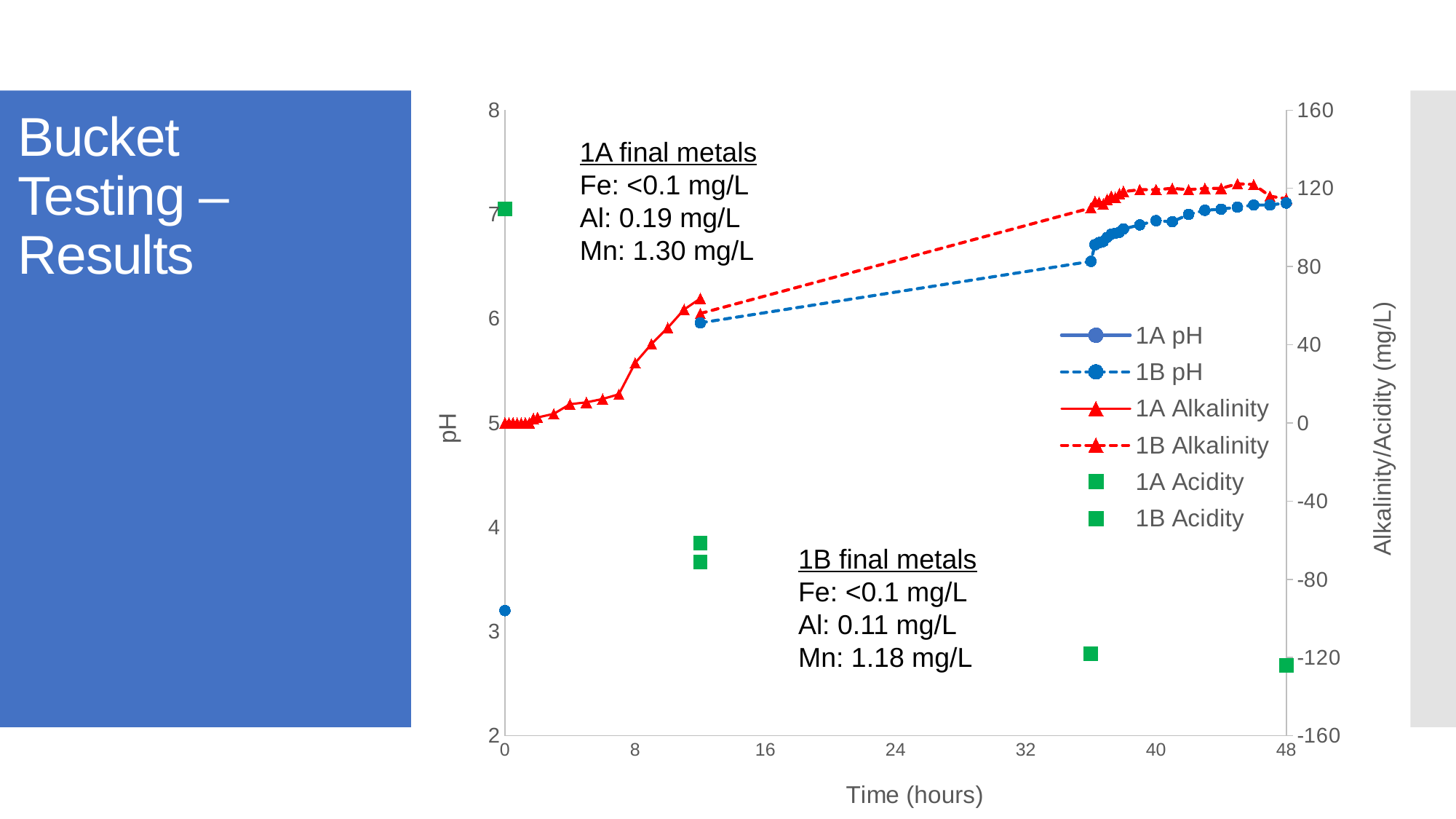
Is the 1B pH value at 12 hours greater or less than 7? less Does the 1B Alkalinity series rise or fall between 12 and 48 hours? rise Is the 1B Acidity value at 48 hours greater or less than -80 mg/L? less Does the 1B pH series rise or fall between 12 and 48 hours? rise Is the 1A Alkalinity value at 0 hours greater or less than 40 mg/L? less How many series does the chart legend list? 6 What is the title of the right-hand y axis? Alkalinity/Acidity (mg/L) What is the title of the x axis? Time (hours) Which is larger: the 1B Alkalinity value at 48 hours or the 1A Alkalinity value at 12 hours? 1B Alkalinity at 48 hours What kind of chart is shown on the slide? line chart